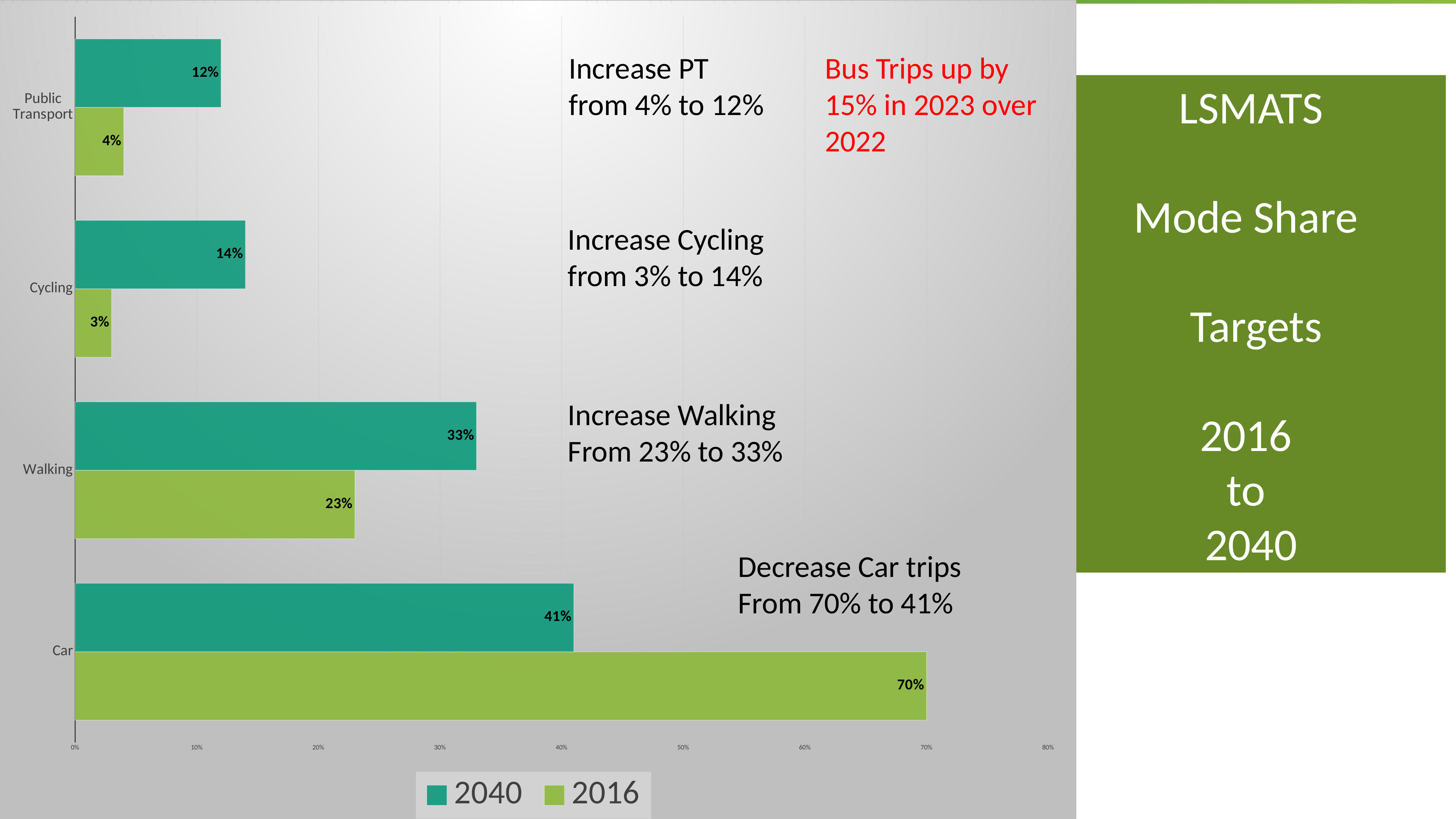
Which is larger for Walking, the 2016 value or the 2040 value? 2040 Which category has the lowest 2016 value? Cycling What is the difference between the 2016 and 2040 values for Car? 29% What kind of chart is shown on the slide? Bar chart How many categories are shown on the chart? 4 How many series does the legend list? 2 What is the 2040 value for Public Transport? 12% What is the 2016 value for Car? 70% What is the 2016 value for Cycling? 3% What is the 2040 value for Walking? 33% Which series is shown in the darker teal colour? 2040 Which category has the highest 2016 value? Car